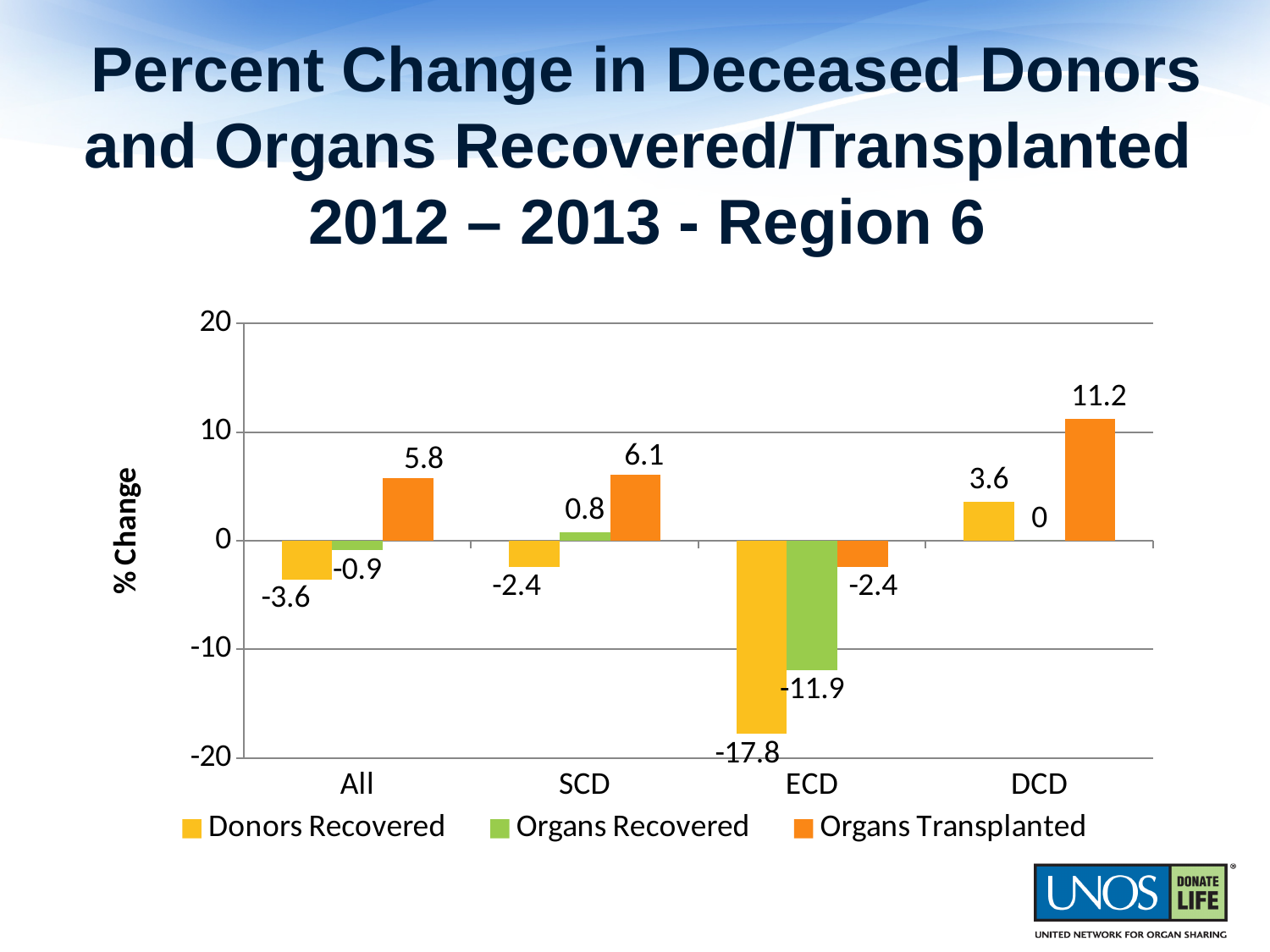
What is the value for Organs Transplanted in the DCD category? 11.2 Which category has the lowest value for Donors Recovered? ECD What kind of chart is shown on the slide? Bar chart What is the label of the y axis? % Change What is the difference between Organs Transplanted and Donors Recovered in the All category? 9.4 How many categories are shown on the x axis? 4 How many series does the legend list? 3 What is the value for Organs Recovered in the SCD category? 0.8 Which category has the highest value for Organs Transplanted? DCD What is the value for Organs Recovered in the DCD category? 0 What is the value for Donors Recovered in the ECD category? -17.8 Which is larger, Organs Recovered for ECD or Organs Recovered for All? Organs Recovered for All